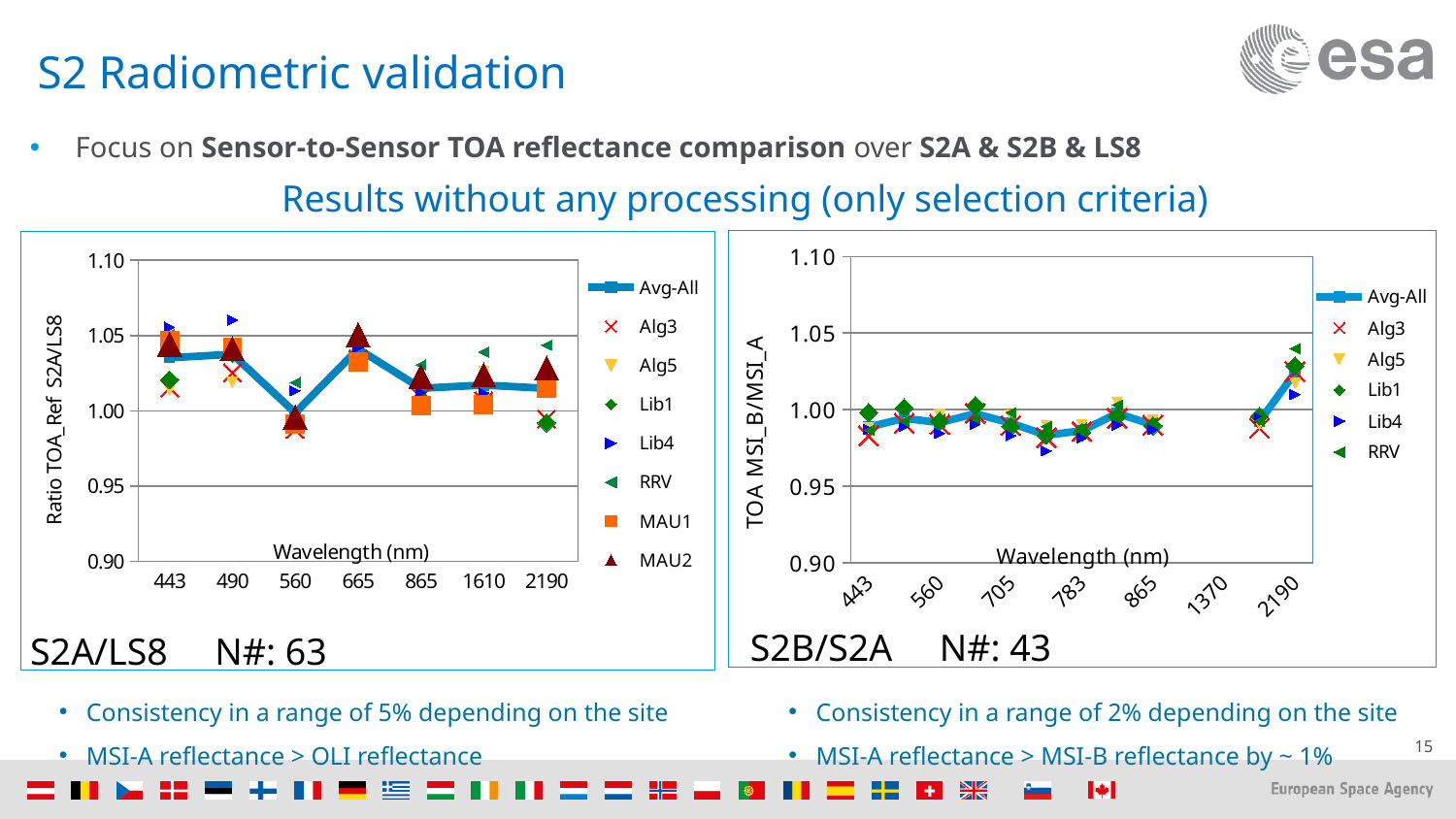
What kind of chart is the S2A/LS8 chart on the left? Line chart How many wavelength categories are labelled on the x axis of the S2A/LS8 chart on the left? 7 How many series does the legend of the S2B/S2A chart on the right list? 6 In the S2A/LS8 chart on the left, which is larger for the Avg-All series: the value at 443 nm or at 560 nm? 443 nm In the S2A/LS8 chart on the left, is the Avg-All value at 665 nm greater or less than 1.05? less What is the y-axis label of the S2B/S2A chart on the right? TOA MSI_B/MSI_A In the S2A/LS8 chart on the left, at which wavelength is the Avg-All series lowest? 560 In the S2A/LS8 chart on the left, which is larger for the Avg-All series: the value at 665 nm or at 865 nm? 665 nm In the S2B/S2A chart on the right, at which wavelength is the Avg-All series highest? 2190 In the S2B/S2A chart on the right, is the Avg-All value at 2190 nm greater or less than 1.00? greater In the S2A/LS8 chart on the left, is the Avg-All value at 443 nm greater or less than 1.00? greater How many series does the legend of the S2A/LS8 chart on the left list? 8